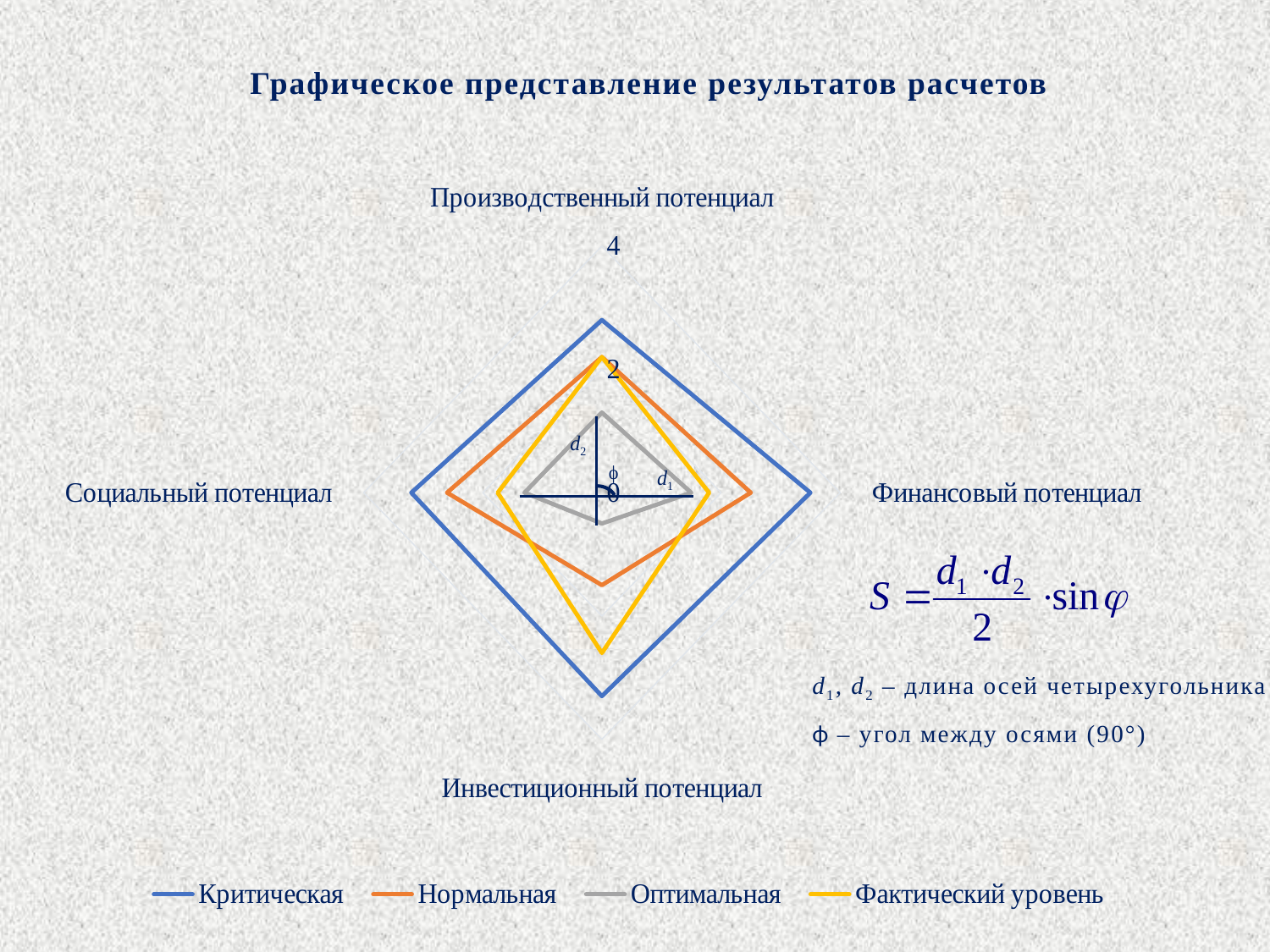
Which series forms the innermost diamond on the chart? Оптимальная On the Социальный потенциал axis, which is larger: Нормальная or Фактический уровень? Нормальная How many series does the legend list? 4 How many axes (categories) does the radar chart have? 4 Which series forms the outermost diamond on the chart? Критическая What kind of chart is shown on the slide? radar chart On the Инвестиционный потенциал axis, which is larger: Фактический уровень or Нормальная? Фактический уровень Is the value of Оптимальная on the Инвестиционный потенциал axis greater or less than 2? less Which series is drawn in yellow in the legend? Фактический уровень Is the value of Нормальная on the Инвестиционный потенциал axis greater or less than 2? less What is the title of the slide containing the chart? Графическое представление результатов расчетов Is the value of Критическая on the Производственный потенциал axis greater or less than 2? greater